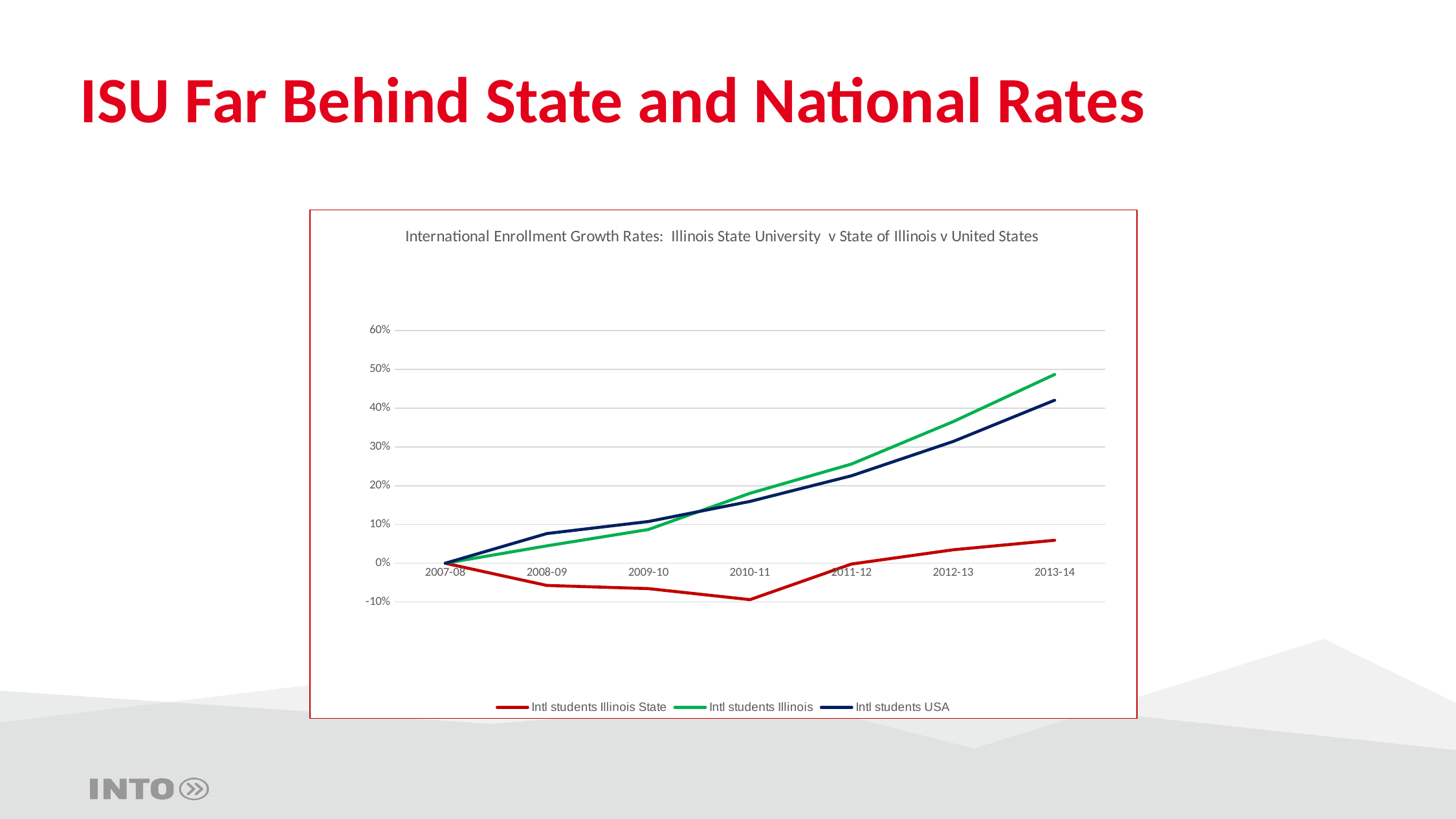
What is the value for Intl students Illinois State in 2007-08? 0% What kind of chart is shown on the slide? line chart In 2008-09, which is larger: Intl students USA or Intl students Illinois? Intl students USA Is the value for Intl students Illinois State in 2010-11 greater or less than 0%? less How many academic years are shown on the x axis? 7 Does the Intl students Illinois series rise or fall from 2007-08 to 2013-14? rise Which series has the lowest value in 2013-14? Intl students Illinois State How many series does the legend list? 3 Is the value for Intl students USA in 2013-14 greater or less than 50%? less Is the value for Intl students Illinois in 2013-14 greater or less than 40%? greater Which series has the highest value in 2013-14? Intl students Illinois What is the title of the chart? International Enrollment Growth Rates: Illinois State University v State of Illinois v United States